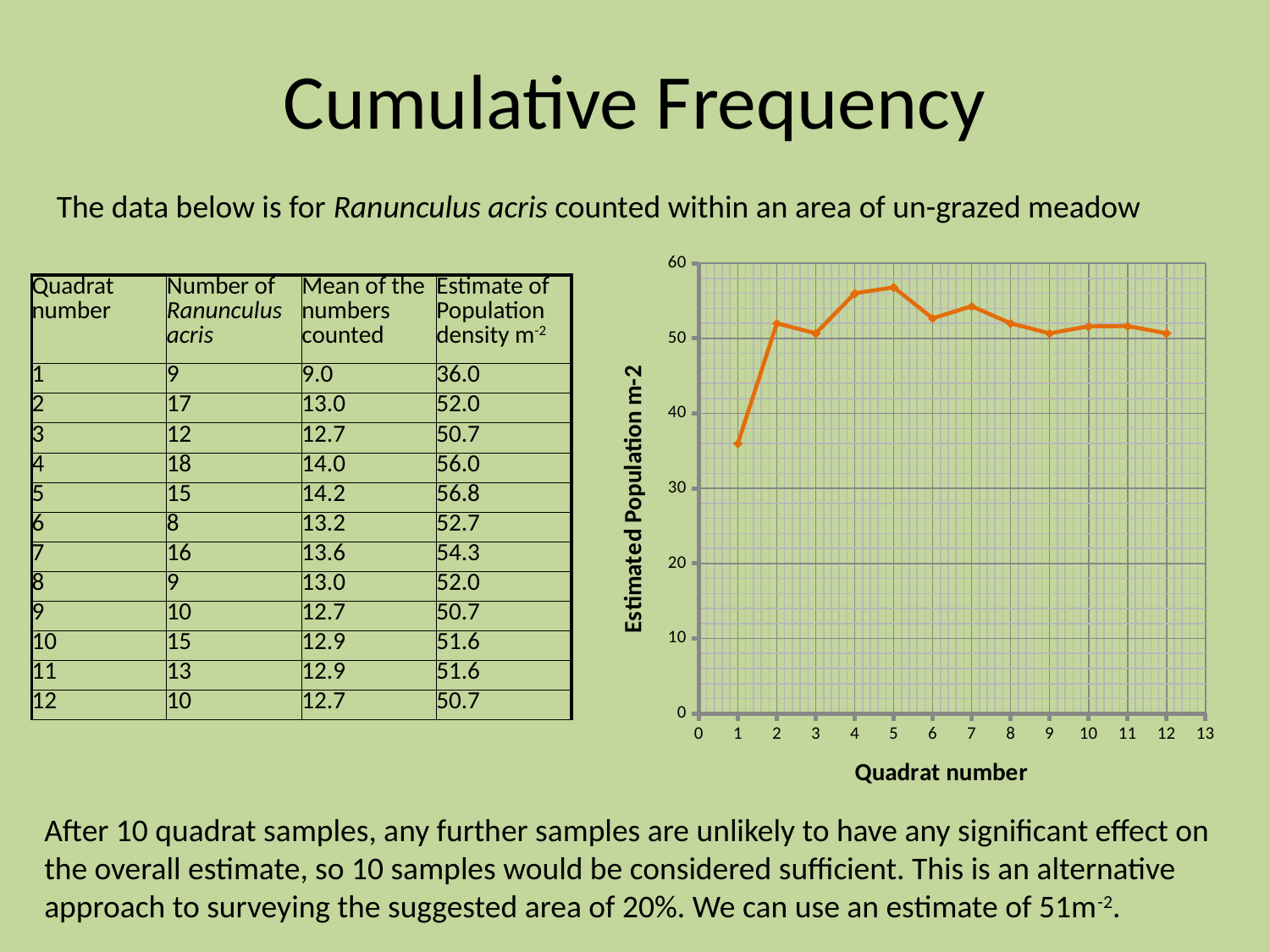
What is the difference between the estimated population density for quadrat 2 and quadrat 1? 16.0 Is the estimated population for quadrat number 4 greater or less than 50? greater Which quadrat number has the highest estimated population on the chart? 5 What is the estimated population density for quadrat number 5? 56.8 How many data points are plotted on the line chart? 12 Does the estimated population rise or fall from quadrat number 1 to quadrat number 2? rise What kind of chart is shown on the slide? line chart Which quadrat number has the lowest estimated population on the chart? 1 Which has the larger estimated population, quadrat number 1 or quadrat number 2? quadrat number 2 What is the title of the x axis of the chart? Quadrat number Is the estimated population for quadrat number 1 greater or less than 40? less What is the estimated population density for quadrat number 1? 36.0